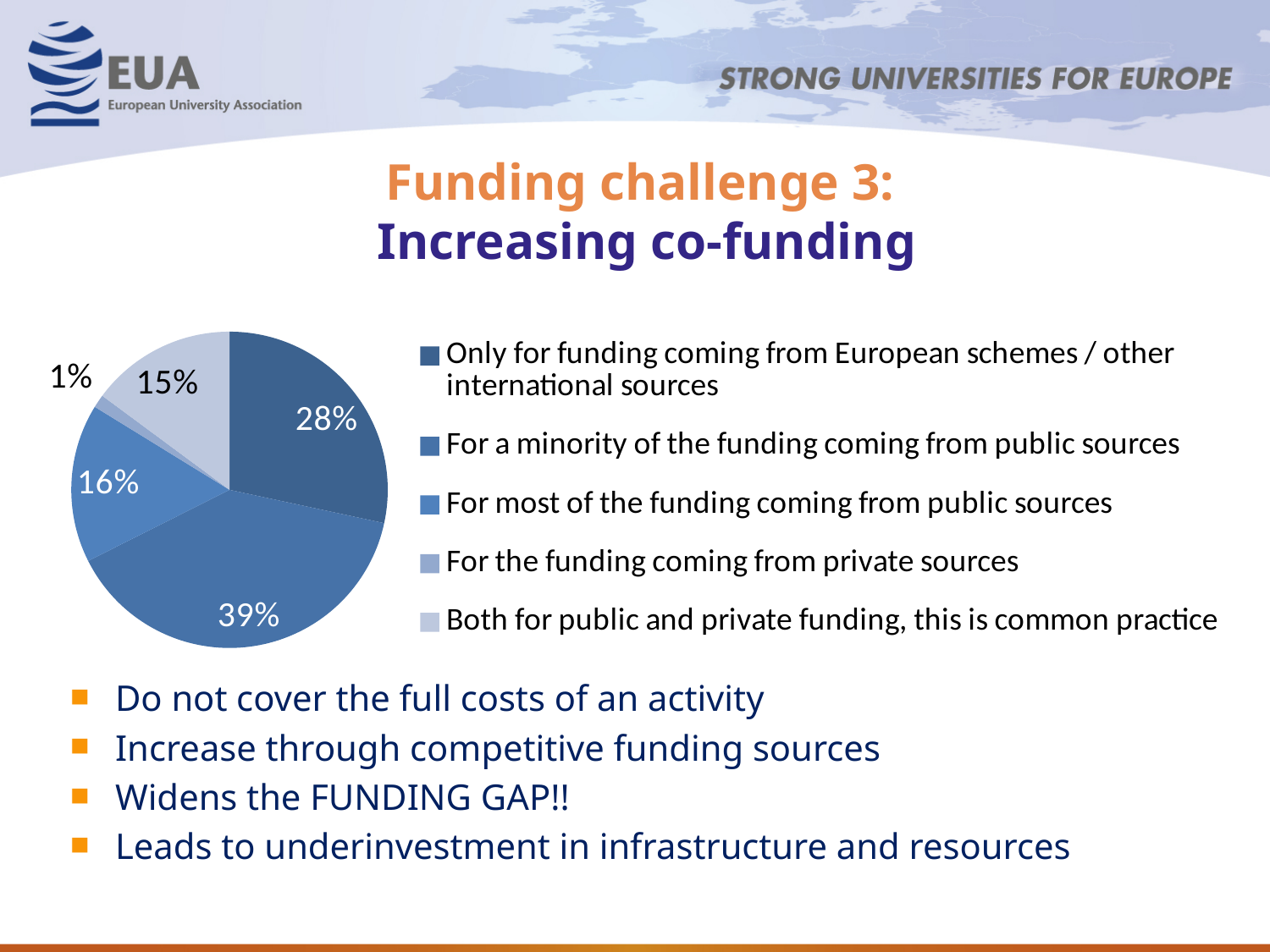
How many slices does the pie chart have? 5 What share of the pie is labelled for 'For most of the funding coming from public sources'? 16% What share of the pie is labelled for 'Both for public and private funding, this is common practice'? 15% What is the difference in percentage points between the 39% slice and the 28% slice? 11 Which category has the smallest slice of the pie? For the funding coming from private sources What share of the pie is labelled for 'For a minority of the funding coming from public sources'? 39% Which is larger: the slice for 'For most of the funding coming from public sources' or the slice for 'Both for public and private funding, this is common practice'? For most of the funding coming from public sources Which category has the largest slice of the pie? For a minority of the funding coming from public sources What share of the pie is labelled for 'Only for funding coming from European schemes / other international sources'? 28% How many entries does the legend list? 5 What share of the pie is labelled for 'For the funding coming from private sources'? 1% What kind of chart is shown on the slide? pie chart